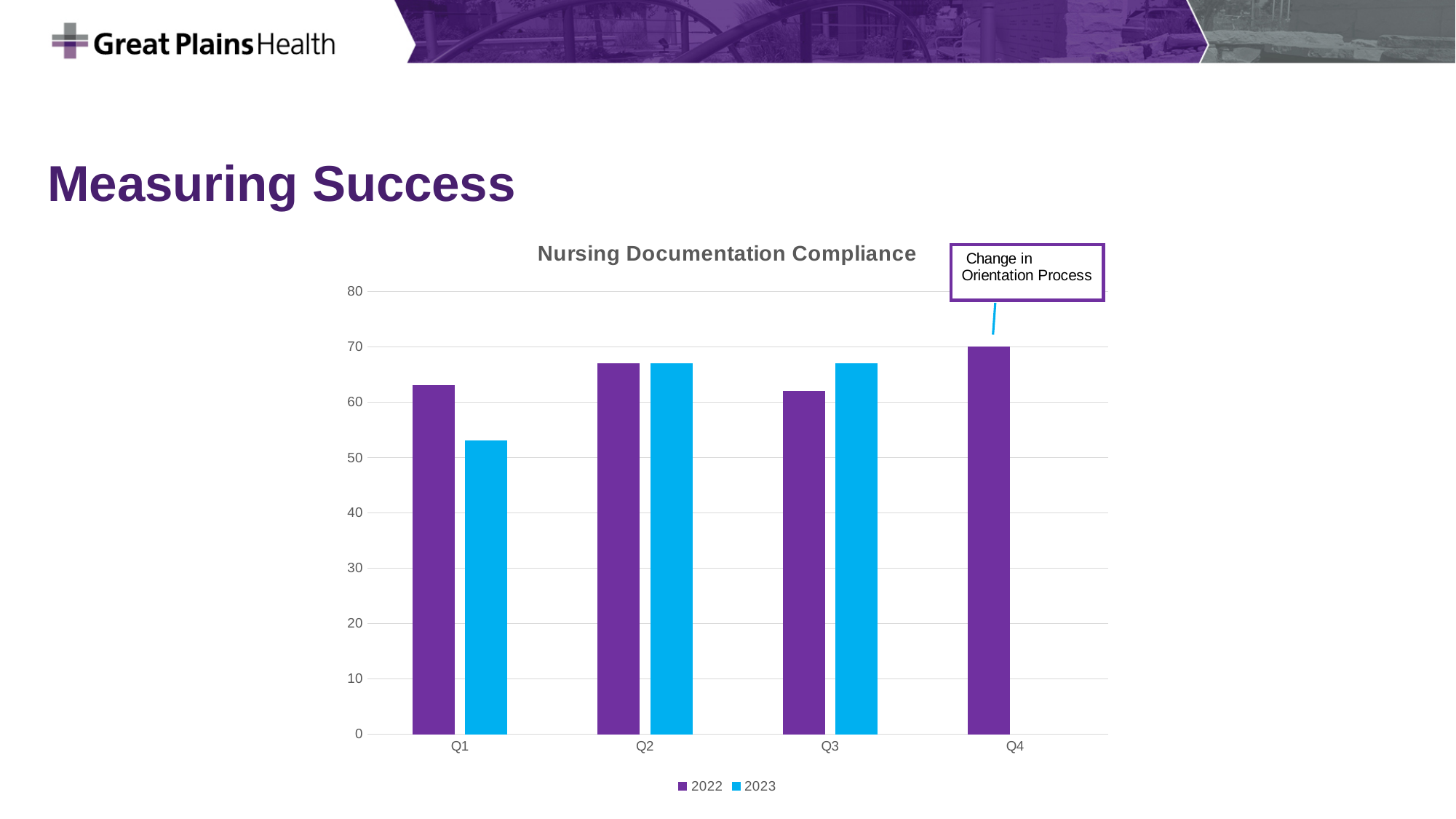
Which quarter has the lowest value for 2023? Q1 How many series does the legend list? 2 What does the callout box pointing to the Q4 bar say? Change in Orientation Process In Q3, which series has the larger value, 2022 or 2023? 2023 Is the value for 2022 in Q3 greater or less than 50? greater In Q1, which series has the larger value, 2022 or 2023? 2022 What kind of chart is shown on the slide? bar chart Which quarter has the highest value for 2022? Q4 Is the value for 2023 in Q1 greater or less than 60? less What is the title of the chart? Nursing Documentation Compliance Is the value for 2022 in Q2 greater or less than 60? greater How many quarters are shown on the x axis? 4